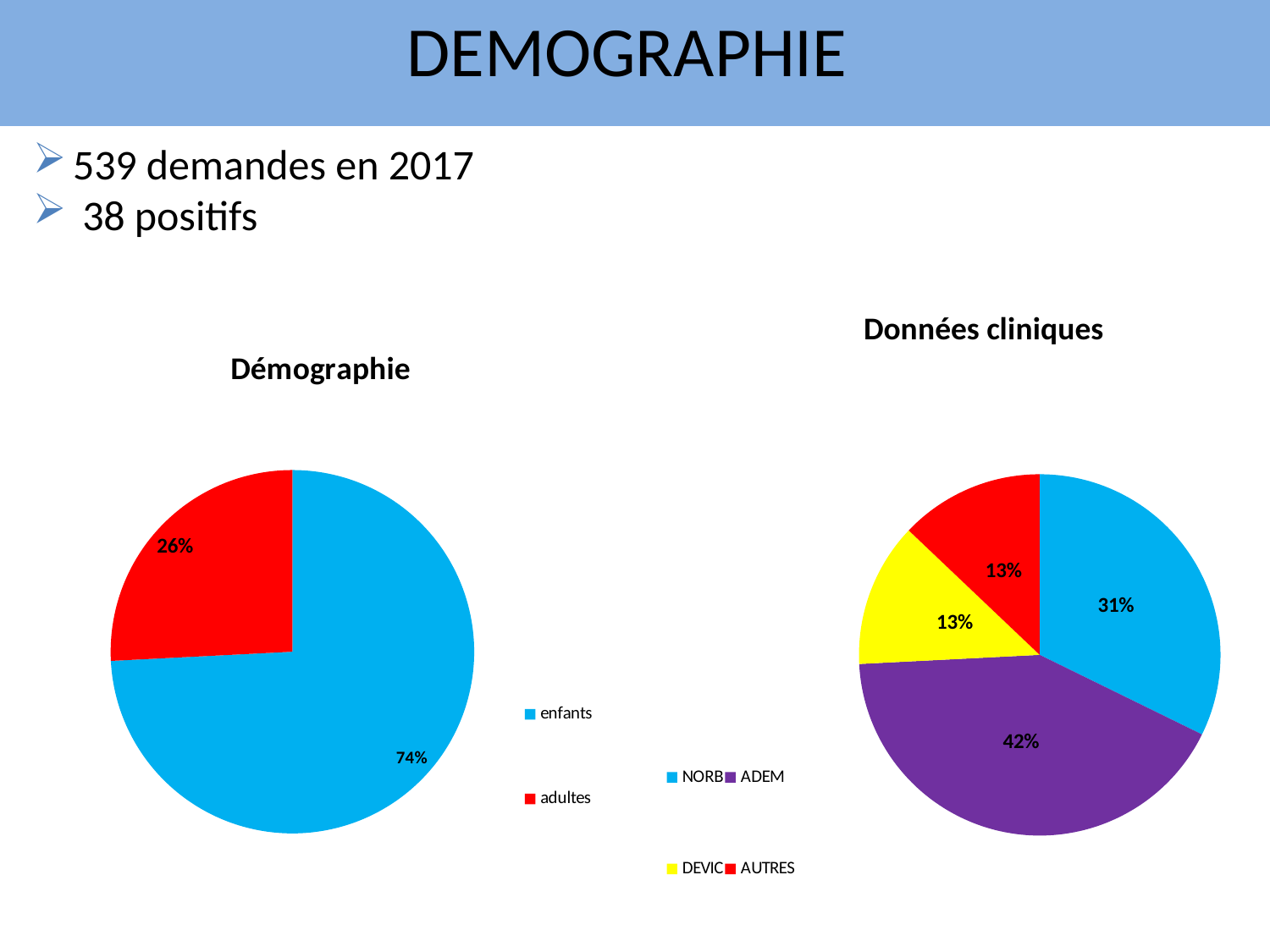
In the 'Données cliniques' chart, what share of the pie is 'NORB'? 31% In the 'Démographie' chart, what is the difference in percentage points between 'enfants' and 'adultes'? 48 In the 'Données cliniques' chart, how many categories does the legend list? 4 In the 'Données cliniques' chart, which category has the largest slice? ADEM In the 'Démographie' chart, what share of the pie is 'enfants'? 74% In the 'Données cliniques' chart, what share of the pie is 'ADEM'? 42% What kind of chart is the 'Démographie' chart? pie chart In the 'Données cliniques' chart, what is the difference in percentage points between 'ADEM' and 'NORB'? 11 In the 'Données cliniques' chart, which is larger, 'NORB' or 'ADEM'? ADEM In the 'Démographie' chart, which category has the largest slice? enfants